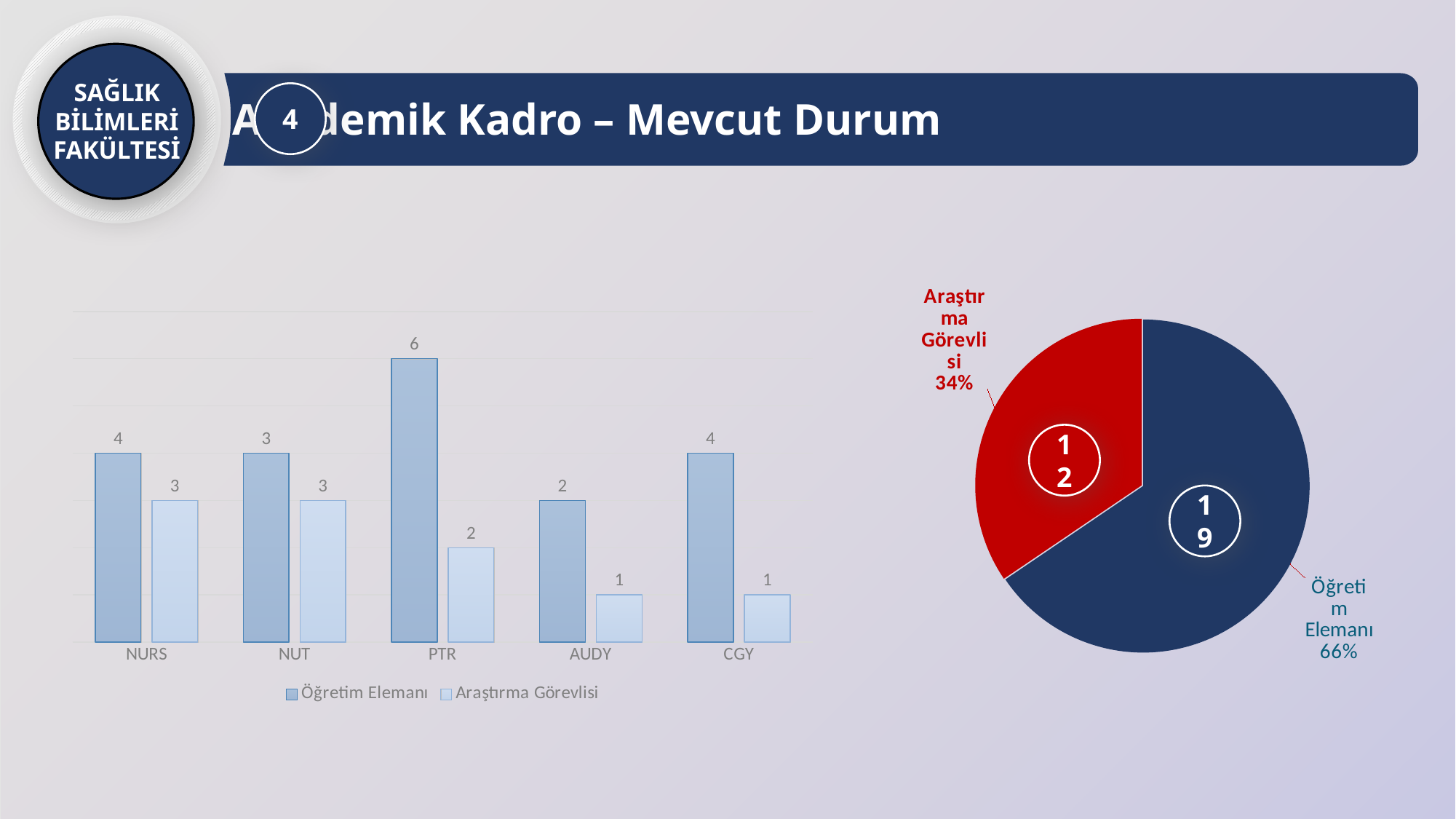
In the bar chart on the left, what is the value of Öğretim Elemanı for PTR? 6 In the bar chart on the left, what is the value of Araştırma Görevlisi for NURS? 3 In the bar chart on the left, which category has the highest Öğretim Elemanı value? PTR In the bar chart on the left, which category has the lowest Öğretim Elemanı value? AUDY In the bar chart on the left, what is the value of Araştırma Görevlisi for CGY? 1 How many series does the legend of the bar chart on the left list? 2 In the pie chart on the right, which slice is larger: Öğretim Elemanı or Araştırma Görevlisi? Öğretim Elemanı In the bar chart on the left, which is larger for NUT: Öğretim Elemanı or Araştırma Görevlisi? Öğretim Elemanı In the bar chart on the left, what is the difference between the Öğretim Elemanı and Araştırma Görevlisi values for PTR? 4 What kind of chart is the chart on the left of the slide? Bar chart How many categories are shown on the x axis of the bar chart on the left? 5 In the pie chart on the right, what share does Araştırma Görevlisi have? 34%